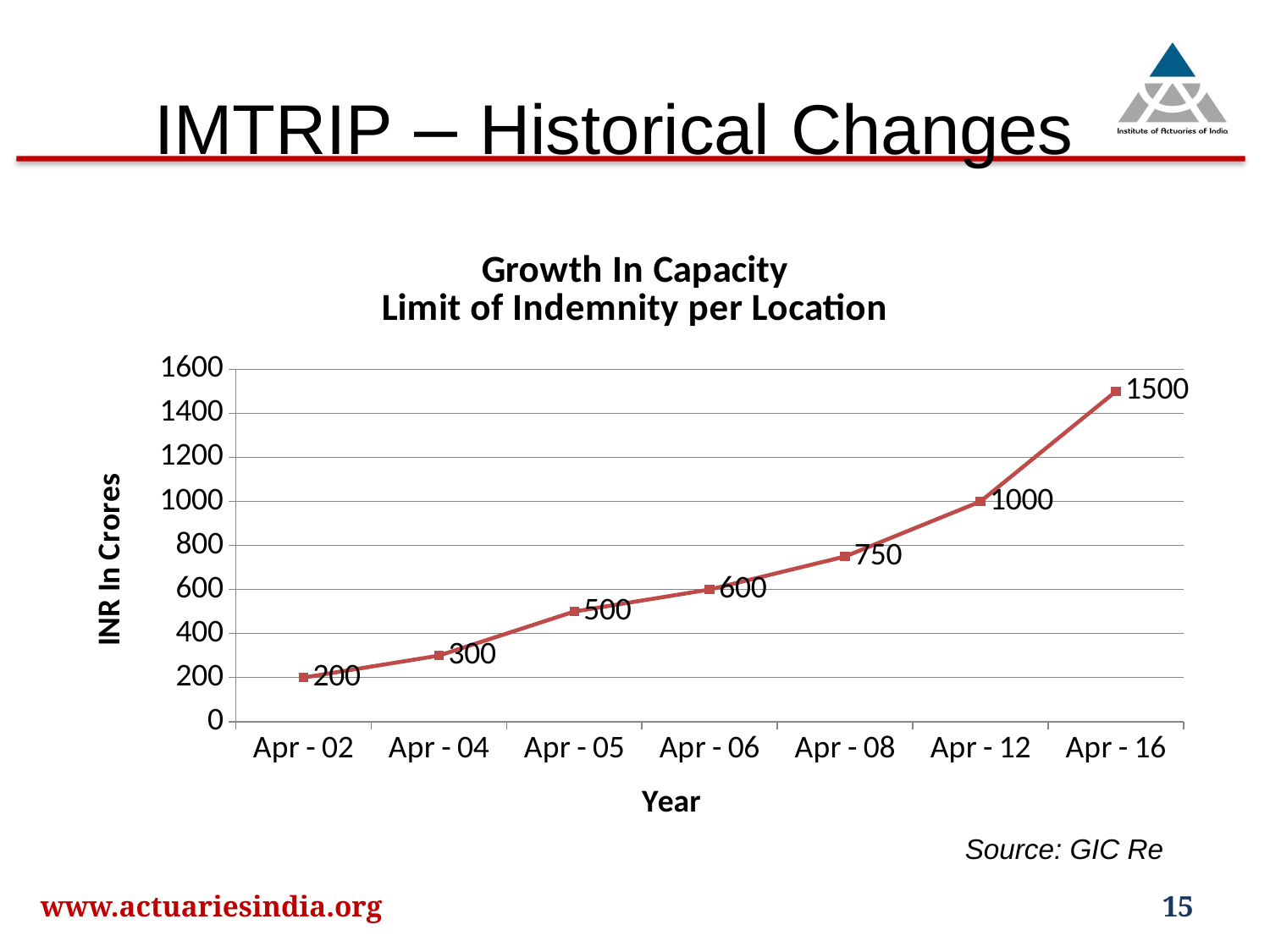
How many data points are plotted on the chart? 7 Do the values rise or fall from Apr - 02 to Apr - 16? Rise What kind of chart is shown on the slide? Line chart What is the value plotted for Apr - 12? 1000 Which year has the highest limit of indemnity per location? Apr - 16 What is the label of the vertical axis? INR In Crores Which is larger, the value for Apr - 06 or the value for Apr - 08? Apr - 08 What is the difference between the values for Apr - 05 and Apr - 04? 200 What is the limit of indemnity per location for Apr - 02? 200 What is the value plotted for Apr - 08? 750 What is the difference between the values for Apr - 16 and Apr - 12? 500 Which year has the lowest limit of indemnity per location? Apr - 02